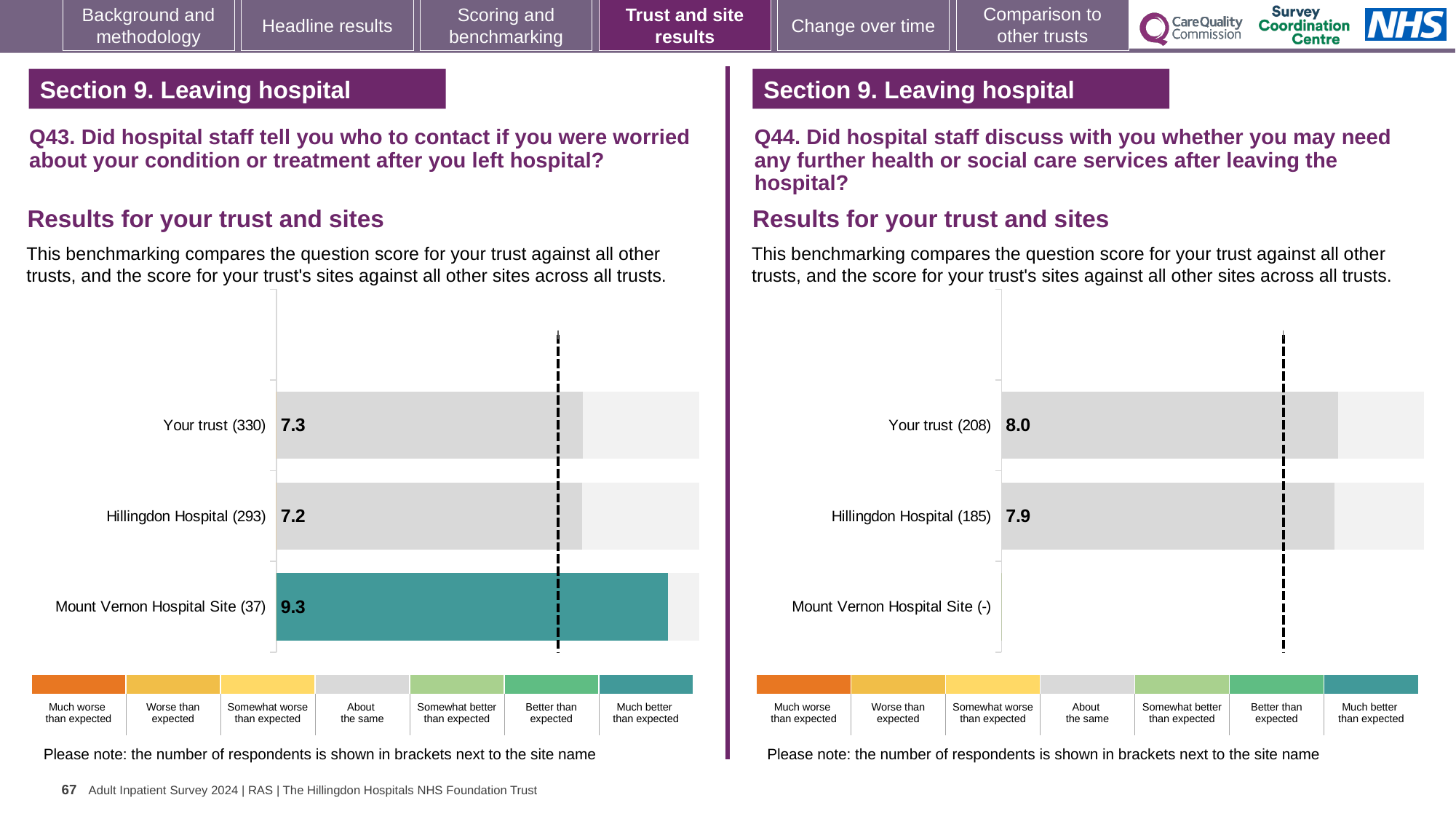
In the Q43 chart on the left, what is the score for Mount Vernon Hospital Site? 9.3 In the Q43 chart on the left, which benchmark category does the colour of the Mount Vernon Hospital Site bar correspond to? Much better than expected In the Q44 chart on the right, what is the score for Your trust? 8.0 In the Q43 chart on the left, what is the score for Your trust? 7.3 In the Q43 chart on the left, what is the difference between the Mount Vernon Hospital Site score and the Your trust score? 2.0 In the Q43 chart on the left, which site or trust has the lowest score? Hillingdon Hospital In the Q44 chart on the right, how many respondents are shown for Your trust? 208 In the Q43 chart on the left, which site or trust has the highest score? Mount Vernon Hospital Site In the Q44 chart on the right, what is the score for Hillingdon Hospital? 7.9 In the Q44 chart on the right, what is the difference between the Your trust score and the Hillingdon Hospital score? 0.1 In the Q43 chart on the left, how many respondents are shown for Mount Vernon Hospital Site? 37 What kind of chart is used in the Q43 chart on the left? Bar chart